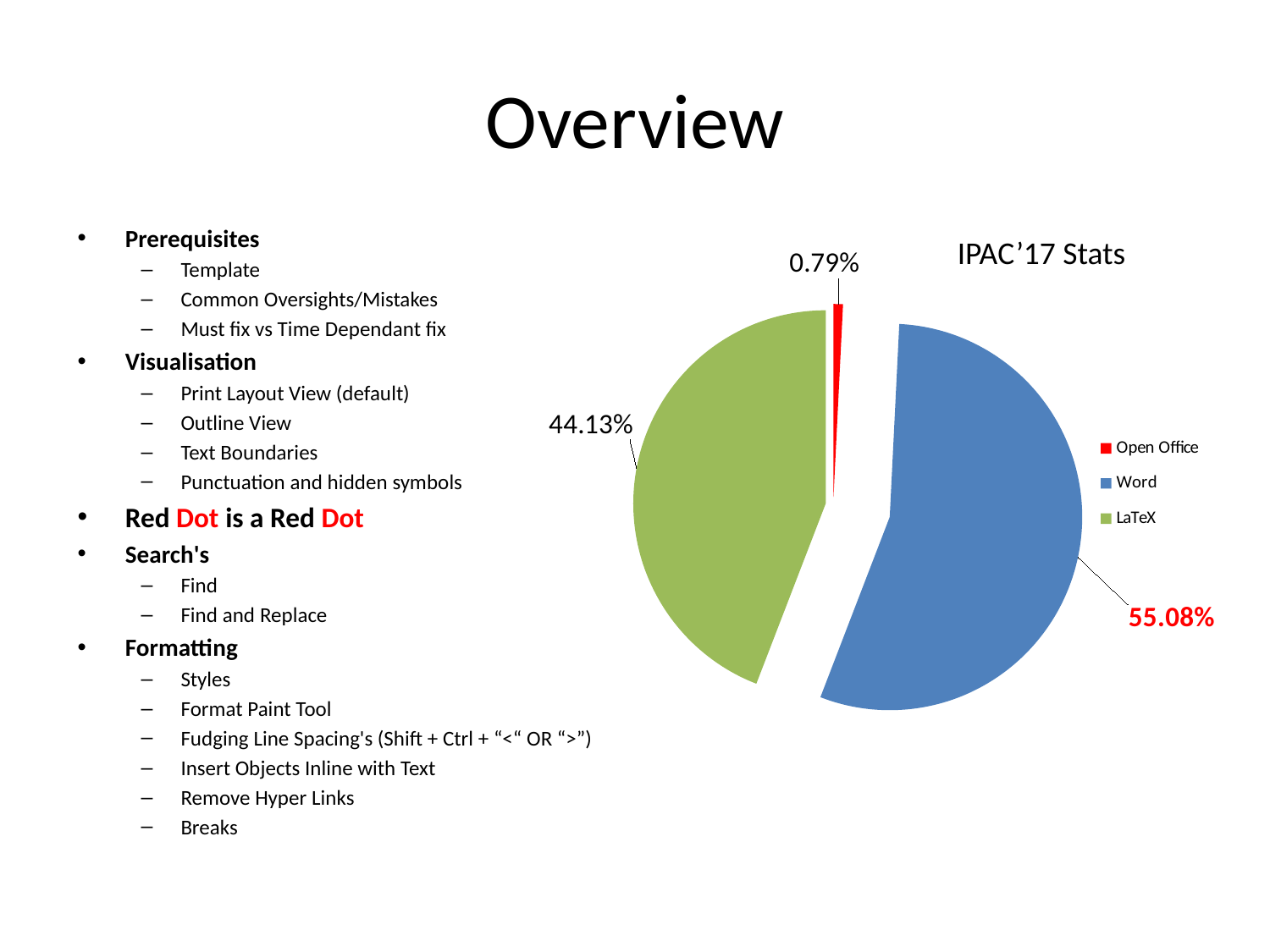
What colour is the Word slice in the pie chart? blue Which is larger, the share for LaTeX or the share for Open Office? LaTeX What percentage of the pie is LaTeX? 44.13% Which category has the largest share of the pie? Word How many slices does the pie chart have? 3 What is the difference between the Word share and the LaTeX share? 10.95% What percentage of the pie is Open Office? 0.79% What percentage of the pie is Word? 55.08% What is the title of the chart? IPAC'17 Stats How many entries does the legend list? 3 What kind of chart is shown on the slide? pie chart Which category has the smallest share of the pie? Open Office